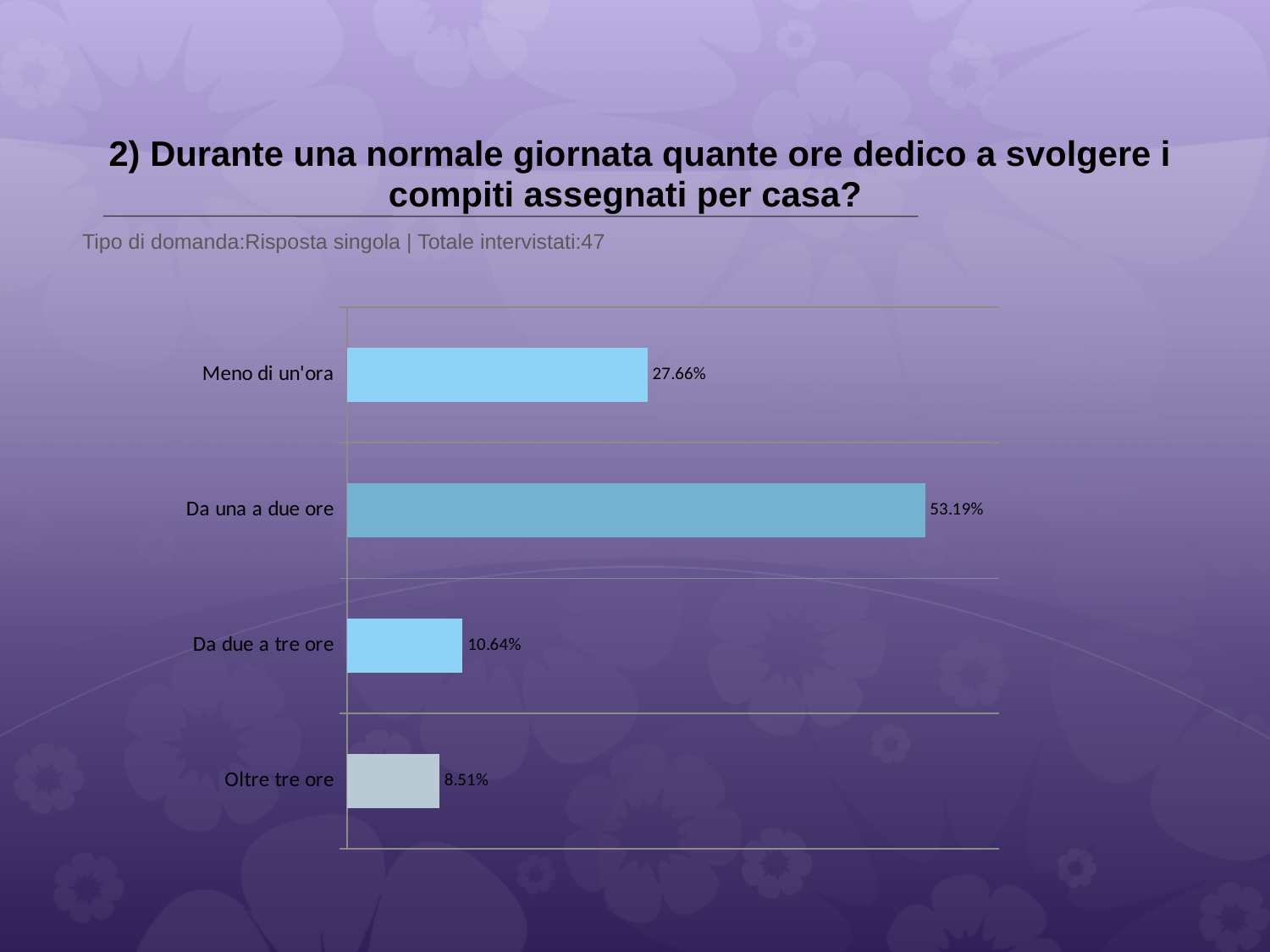
Which category has the lowest value? Oltre tre ore How many respondents does the slide say were interviewed in total? 47 What is the difference between the values for "Da una a due ore" and "Meno di un'ora"? 25.53% What is the value for "Oltre tre ore"? 8.51% What is the difference between the values for "Da due a tre ore" and "Oltre tre ore"? 2.13% How many categories are shown in the chart? 4 What kind of chart is shown on the slide? Bar chart Which is larger, the value for "Meno di un'ora" or the value for "Da due a tre ore"? Meno di un'ora Which category has the highest value? Da una a due ore What is the value for "Da una a due ore"? 53.19% What is the value for "Da due a tre ore"? 10.64% What is the value for "Meno di un'ora"? 27.66%